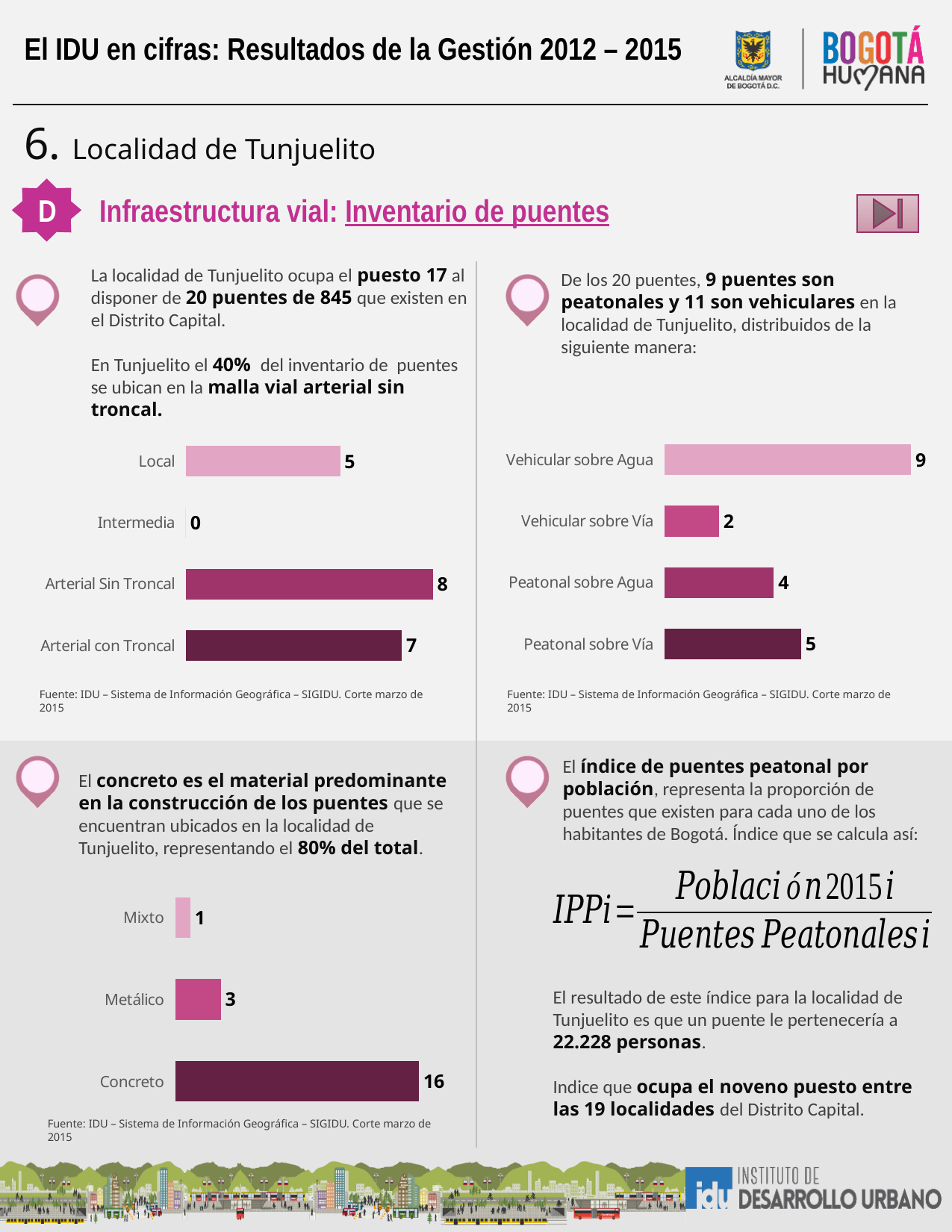
In the top-left chart, what is the difference between Arterial Sin Troncal and Local? 3 In the top-left chart, which category has the lowest value? Intermedia In the bottom-left chart, what is the value for Concreto? 16 In the top-left chart, which category has the highest value? Arterial Sin Troncal In the top-right chart, what is the value for Peatonal sobre Agua? 4 In the top-right chart, what is the difference between Vehicular sobre Agua and Vehicular sobre Vía? 7 What kind of chart is the bottom-left chart? Bar chart In the top-right chart, which is larger, Peatonal sobre Vía or Vehicular sobre Vía? Peatonal sobre Vía In the bottom-left chart, which category has the lowest value? Mixto In the top-right chart, which category has the highest value? Vehicular sobre Agua How many categories does the top-left chart show? 4 In the top-left chart, what is the value for Arterial Sin Troncal? 8